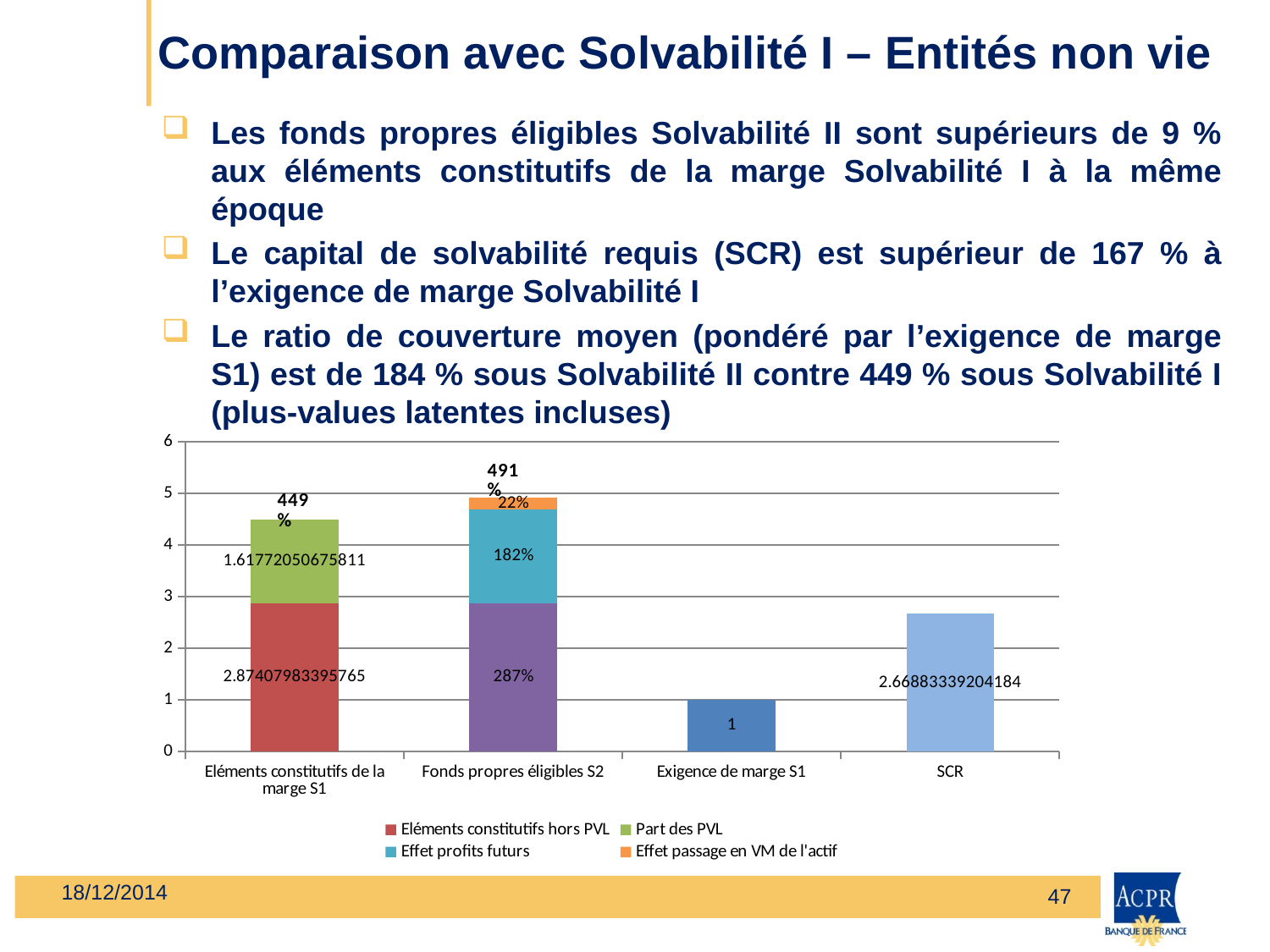
What is the value of the Effet passage en VM de l'actif segment in the Fonds propres éligibles S2 bar? 22% What is the value of the Effet profits futurs segment in the Fonds propres éligibles S2 bar? 182% What is the value of the Eléments constitutifs hors PVL segment in the Eléments constitutifs de la marge S1 bar? 2.87407983395765 Which category has the tallest bar in the chart? Fonds propres éligibles S2 What kind of chart is shown on the slide? Bar chart Which category has the lowest bar in the chart? Exigence de marge S1 How many categories are shown on the x axis of the chart? 4 What is the value shown for SCR? 2.66883339204184 Is the value for SCR greater or less than 3? less What is the value of the Part des PVL segment in the Eléments constitutifs de la marge S1 bar? 1.61772050675811 How many series does the chart legend list? 4 What is the value shown for Exigence de marge S1? 1